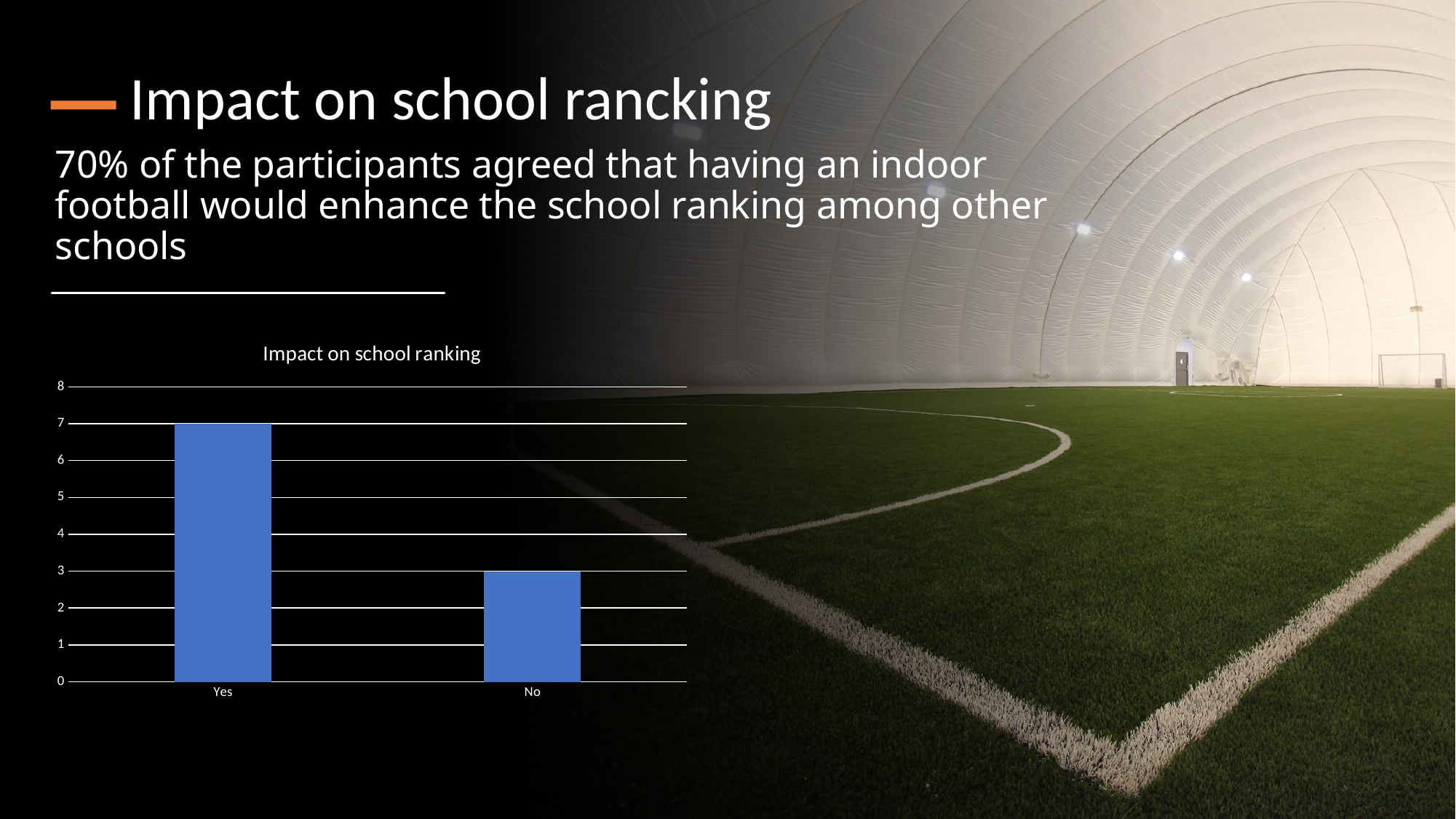
Is the value for Yes greater or less than 5? greater Which category has the highest value in the chart? Yes What is the difference between the values for Yes and No? 4 Is the value for No greater or less than 4? less Which is larger, the value for Yes or the value for No? Yes How many categories are shown on the x axis of the chart? 2 Which category has the lowest value in the chart? No What is the maximum value shown on the y axis of the chart? 8 What type of chart is shown on the slide? bar chart What is the title of the chart? Impact on school ranking What is the value for Yes in the chart? 7 What is the value for No in the chart? 3